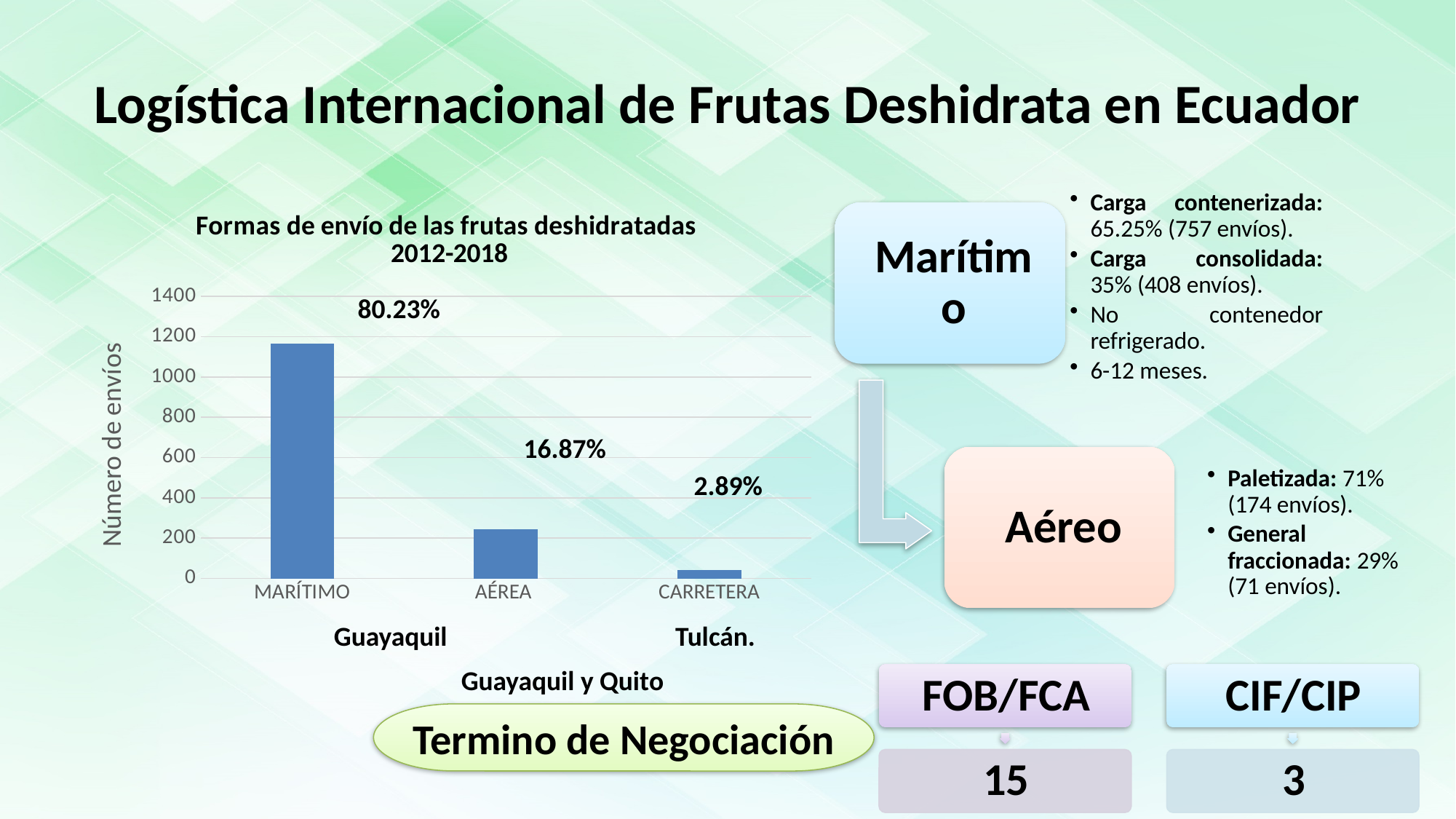
Is the number of shipments for CARRETERA greater or less than 200? less What type of chart is used to show the shipping modes? Bar chart What percentage label is shown on the AÉREA bar? 16.87% Which shipping mode has the highest number of shipments? MARÍTIMO Is the number of shipments for MARÍTIMO greater or less than 1000? greater Which shipping mode has the lowest number of shipments? CARRETERA How many shipping modes are shown on the x axis of the chart? 3 Which has more shipments, AÉREA or CARRETERA? AÉREA What percentage label is shown on the CARRETERA bar? 2.89% What is the difference between the percentage labels for MARÍTIMO and AÉREA? 63.36% Is the number of shipments for AÉREA greater or less than 400? less What percentage label is shown on the MARÍTIMO bar? 80.23%